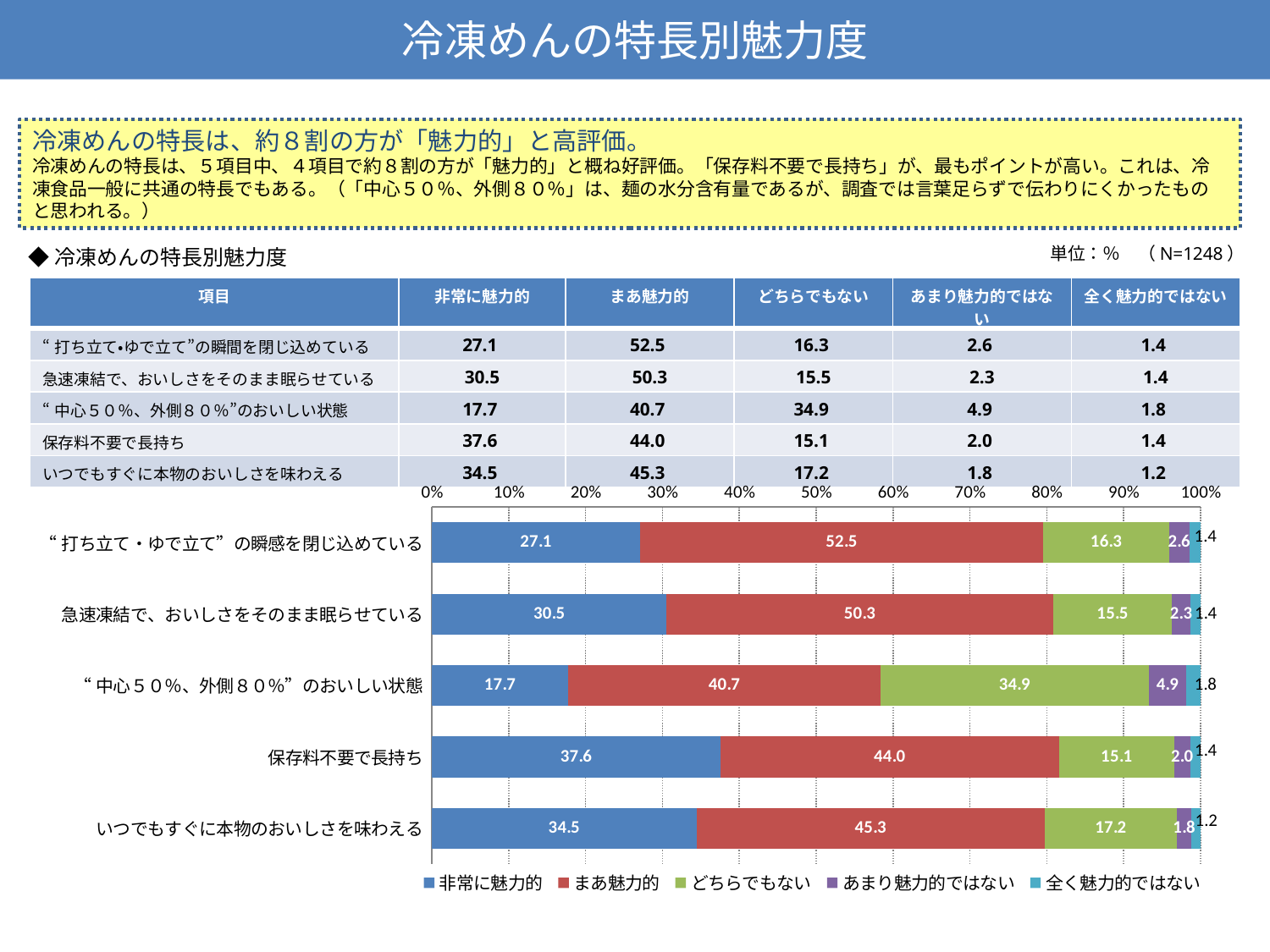
What type of chart is shown on the slide? Stacked bar chart How many categories (items) are plotted in the chart? 5 What is the どちらでもない value for “中心５０％、外側８０％”のおいしい状態? 34.9 Is the 非常に魅力的 value for 保存料不要で長持ち greater or less than 30%? greater What is the difference between the まあ魅力的 values for “打ち立て・ゆで立て”の瞬間を閉じ込めている and 保存料不要で長持ち? 8.5 Which category has the highest 非常に魅力的 value? 保存料不要で長持ち Which series is shown in red in the chart? まあ魅力的 How many series does the chart legend list? 5 What is the 非常に魅力的 value for 保存料不要で長持ち? 37.6 What is the まあ魅力的 value for 急速凍結で、おいしさをそのまま眠らせている? 50.3 Which category has the lowest 非常に魅力的 value? “中心５０％、外側８０％”のおいしい状態 Which is larger: the 非常に魅力的 value for いつでもすぐに本物のおいしさを味わえる or for 急速凍結で、おいしさをそのまま眠らせている? いつでもすぐに本物のおいしさを味わえる